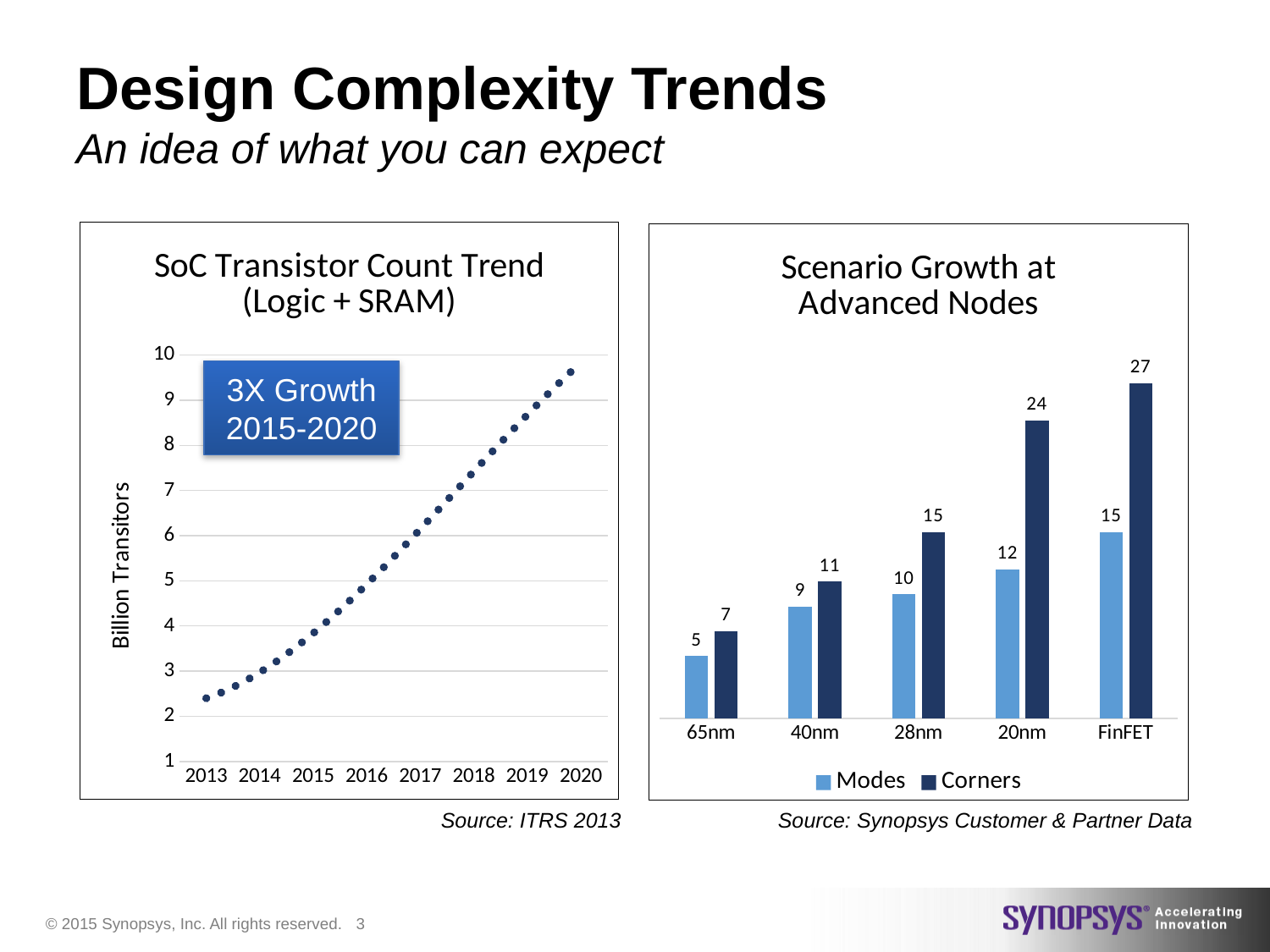
In the 'Scenario Growth at Advanced Nodes' chart, which node has the lowest Modes value? 65nm How many series does the legend of the 'Scenario Growth at Advanced Nodes' chart list? 2 In the 'Scenario Growth at Advanced Nodes' chart, which is larger for 28nm: Modes or Corners? Corners In the 'Scenario Growth at Advanced Nodes' chart, what is the value of Modes for 65nm? 5 What kind of chart is the 'Scenario Growth at Advanced Nodes' chart? Bar chart In the 'Scenario Growth at Advanced Nodes' chart, what is the difference between Corners and Modes for 20nm? 12 In the 'Scenario Growth at Advanced Nodes' chart, what is the value of Corners for 20nm? 24 In the 'Scenario Growth at Advanced Nodes' chart, which node has the highest Corners value? FinFET In the 'Scenario Growth at Advanced Nodes' chart, what is the value of Corners for FinFET? 27 In the 'SoC Transistor Count Trend (Logic + SRAM)' chart, is the value for 2020 greater or less than 9 billion transistors? greater In the 'SoC Transistor Count Trend (Logic + SRAM)' chart, do the values rise or fall from 2013 to 2020? Rise How many nodes are shown on the x axis of the 'Scenario Growth at Advanced Nodes' chart? 5